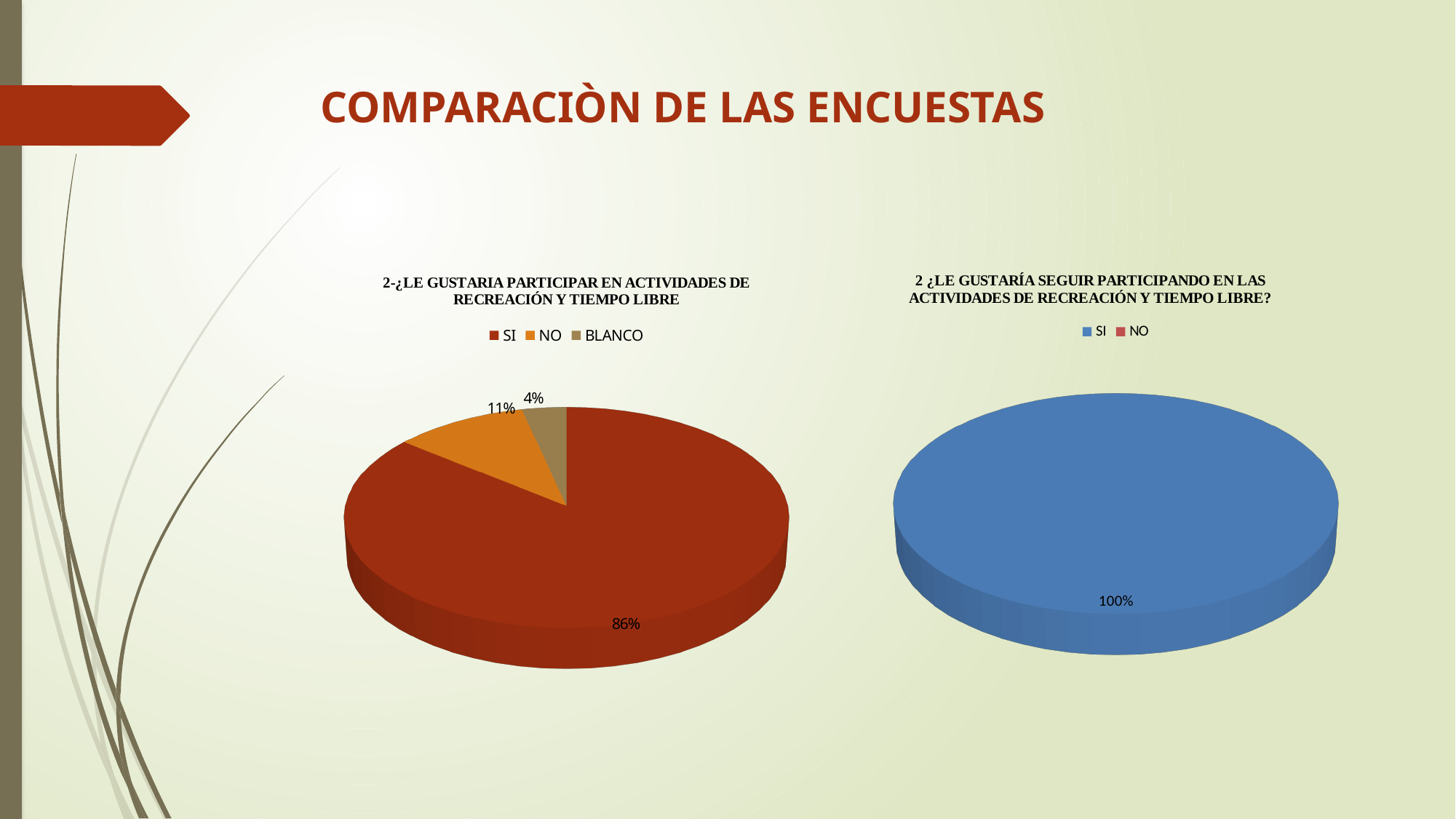
In the left pie chart, what percentage is shown for BLANCO? 4% What colour is the SI slice in the right pie chart? Blue How many categories does the legend of the left pie chart list? 3 In the left pie chart, which category has the largest slice? SI How many categories does the legend of the right pie chart list? 2 In the left pie chart, which is larger, NO or BLANCO? NO What type of chart is used on the right side of the slide? Pie chart In the left pie chart, what percentage is shown for NO? 11% In the left pie chart, which category has the smallest slice? BLANCO In the left pie chart, what is the difference in percentage points between SI and NO? 75 In the right pie chart, what percentage is shown for SI? 100% In the left pie chart, what percentage is shown for SI? 86%